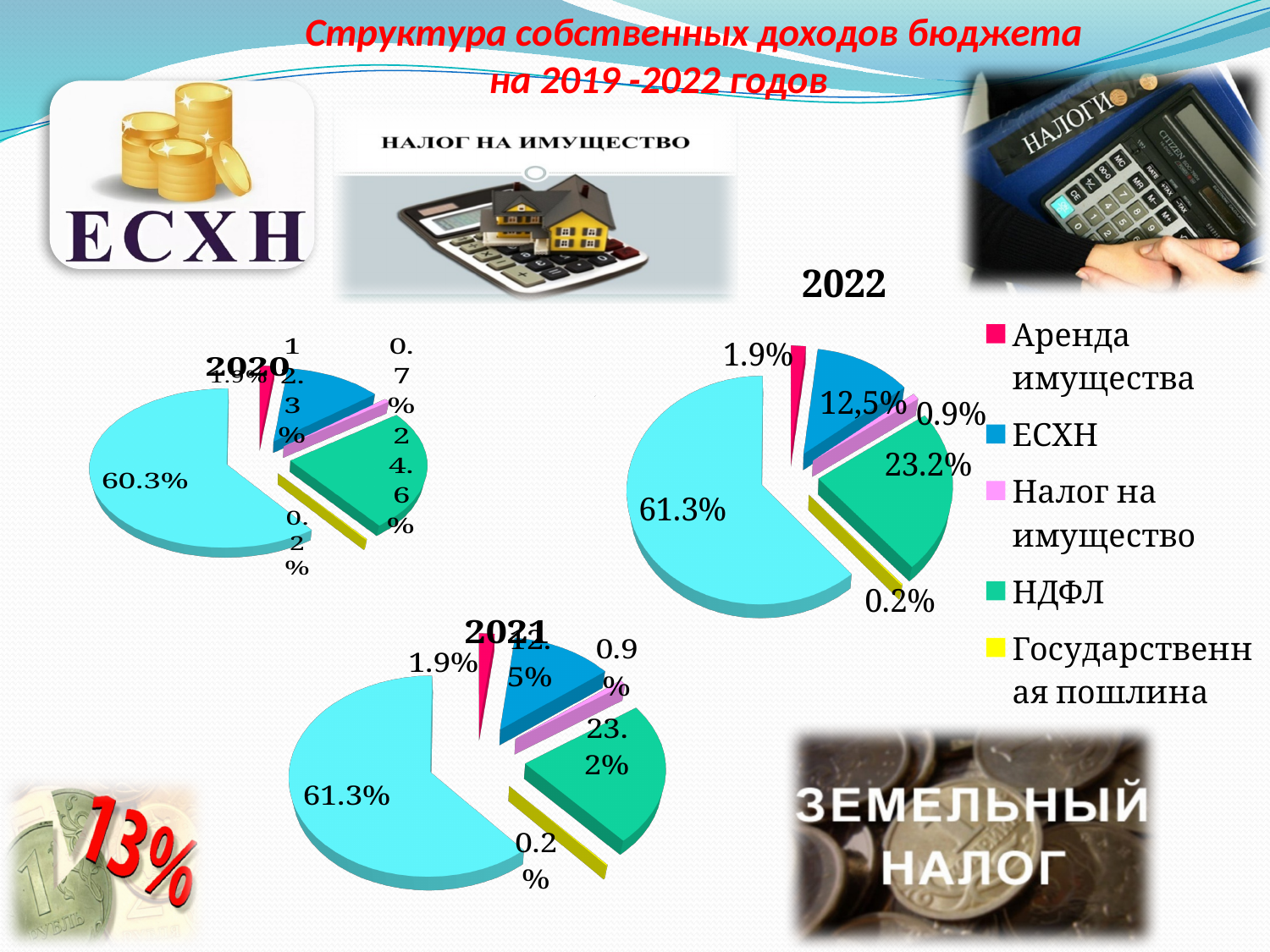
What kind of chart is used for the 2022 chart? pie chart In the 2020 chart, what share does Налог на имущество have? 0.7% In the 2022 chart, what share does ЕСХН have? 12,5% In the 2022 chart, what share does НДФЛ have? 23.2% In the 2022 chart, which legend category has the smallest share? Государственная пошлина In the 2021 chart, what share does Государственная пошлина have? 0.2% How many entries does the legend list? 5 In the 2021 chart, what is the difference between the share for НДФЛ and the share for ЕСХН? 10.7% What is the value of the largest slice in the 2020 chart? 60.3% In the 2020 chart, what share does НДФЛ have? 24.6% In the 2020 chart, which is larger, the share for ЕСХН or the share for НДФЛ? НДФЛ In the 2021 chart, what share does Аренда имущества have? 1.9%